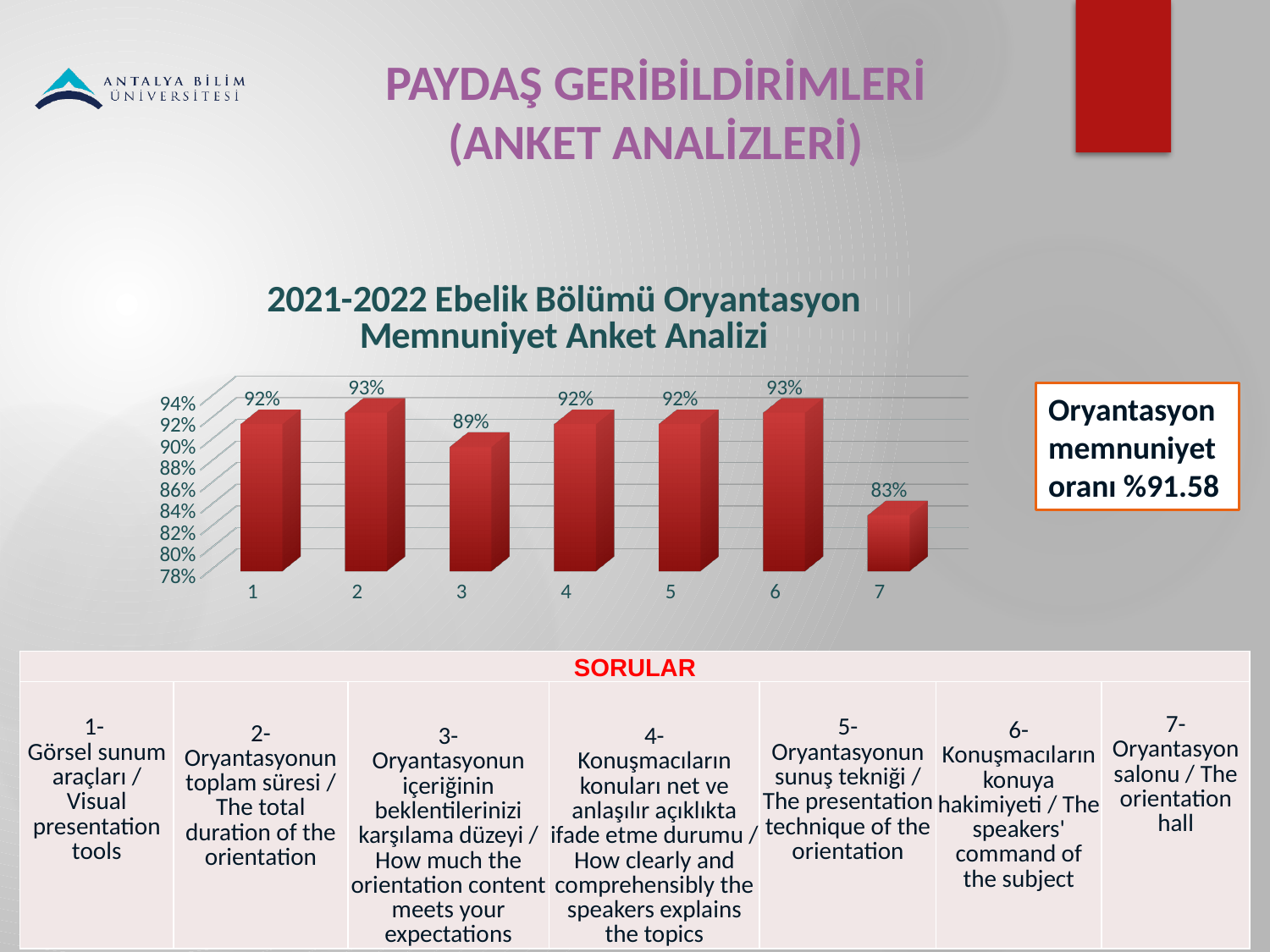
What kind of chart is shown on the slide? bar chart How many categories are shown on the x axis? 7 What is the value for category 1? 92% What is the difference between the values for category 2 and category 3? 4% What is the difference between the values for category 6 and category 7? 10% Which category has the lowest value? 7 Is the value for category 7 greater or less than 86%? less What is the title of the chart? 2021-2022 Ebelik Bölümü Oryantasyon Memnuniyet Anket Analizi Which is larger, the value for category 3 or the value for category 4? category 4 What is the value for category 7? 83% What is the value for category 2? 93% What is the value for category 3? 89%